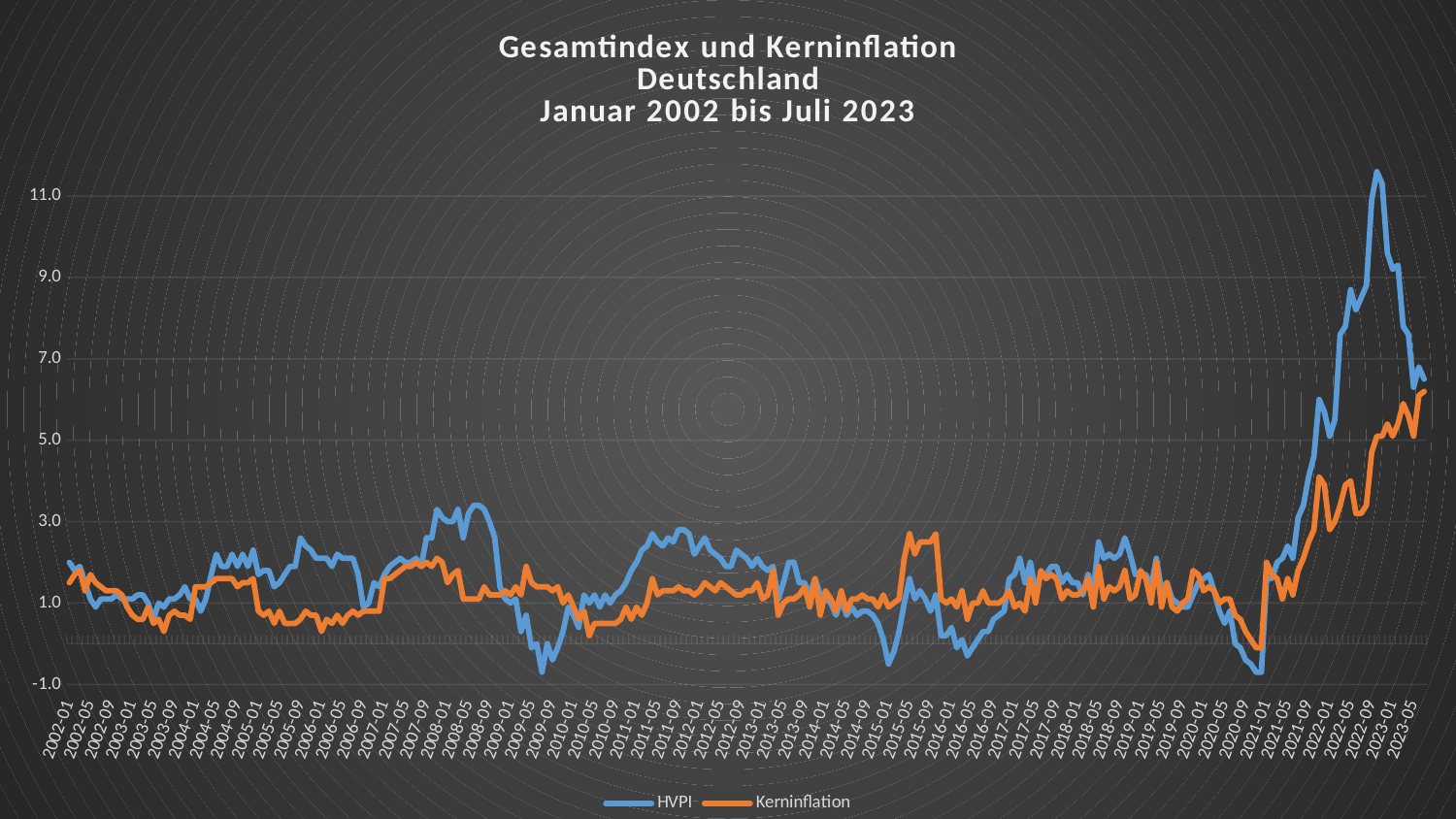
Is the value of HVPI around 2008-07 greater or less than 3.0? greater At 2022-10, which series has the larger value, HVPI or Kerninflation? HVPI Which series reaches the highest value on the chart? HVPI How many series does the legend list? 2 Does the HVPI line rise or fall between 2021-01 and 2022-10? rise What are the two series named in the legend? HVPI and Kerninflation Is the peak value of HVPI in late 2022 greater or less than 9.0? greater Around 2015-01, which series has the larger value, HVPI or Kerninflation? Kerninflation Is the value of HVPI around 2009-07 greater or less than 1.0? less What colour is the HVPI line? blue What kind of chart is shown on the slide? line chart